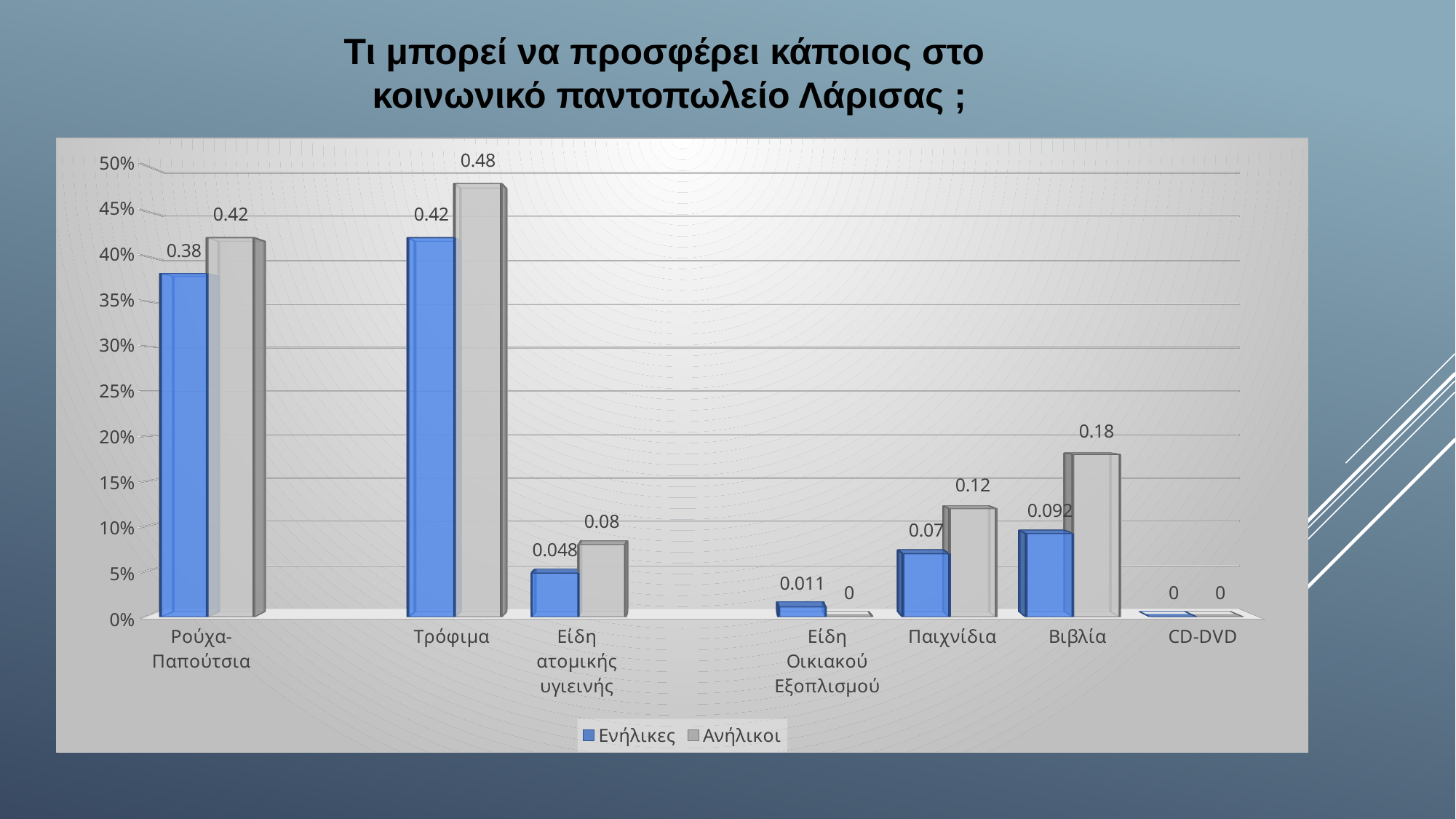
Which colour represents the Ενήλικες series? Blue What is the value for Ανήλικοι in the Βιβλία category? 0.18 Which category has the lowest value for Ενήλικες? CD-DVD What is the value for Ενήλικες in the Τρόφιμα category? 0.42 What kind of chart is shown on the slide? Bar chart Is the Ενήλικες value for Ρούχα-Παπούτσια greater or less than 35%? greater What is the difference between the Ανήλικοι and Ενήλικες values for Ρούχα-Παπούτσια? 0.04 Which category has the highest value for Ανήλικοι? Τρόφιμα How many categories are shown on the x axis? 7 Which is larger for Παιχνίδια: the Ενήλικες value or the Ανήλικοι value? Ανήλικοι How many series does the legend list? 2 What is the value for Ενήλικες in the Είδη Οικιακού Εξοπλισμού category? 0.011